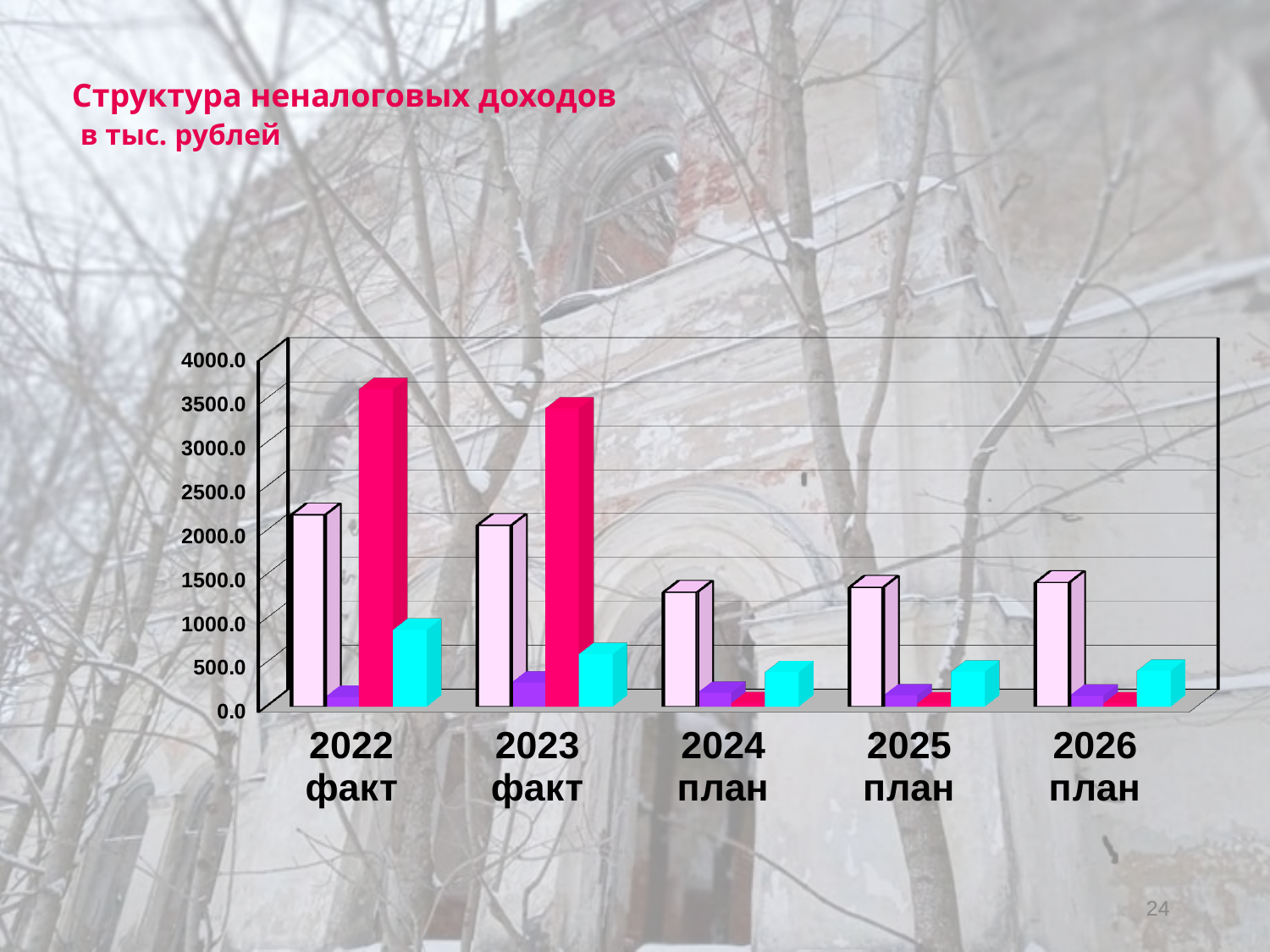
What is the title of the chart on the slide? Структура неналоговых доходов в тыс. рублей Is the value of the light pink bar for 2024 план greater or less than 1500.0? less Is the value of the magenta bar for 2023 факт greater or less than 3000.0? greater Is the value of the light pink bar for 2022 факт greater or less than 2000.0? greater How many categories are shown along the x axis of the chart? 5 How many bars are plotted for each category in the chart? 4 For 2022 факт, which is larger: the magenta bar or the light pink bar? the magenta bar In which category is the magenta bar the tallest? 2022 факт What kind of chart is shown on the slide? bar chart